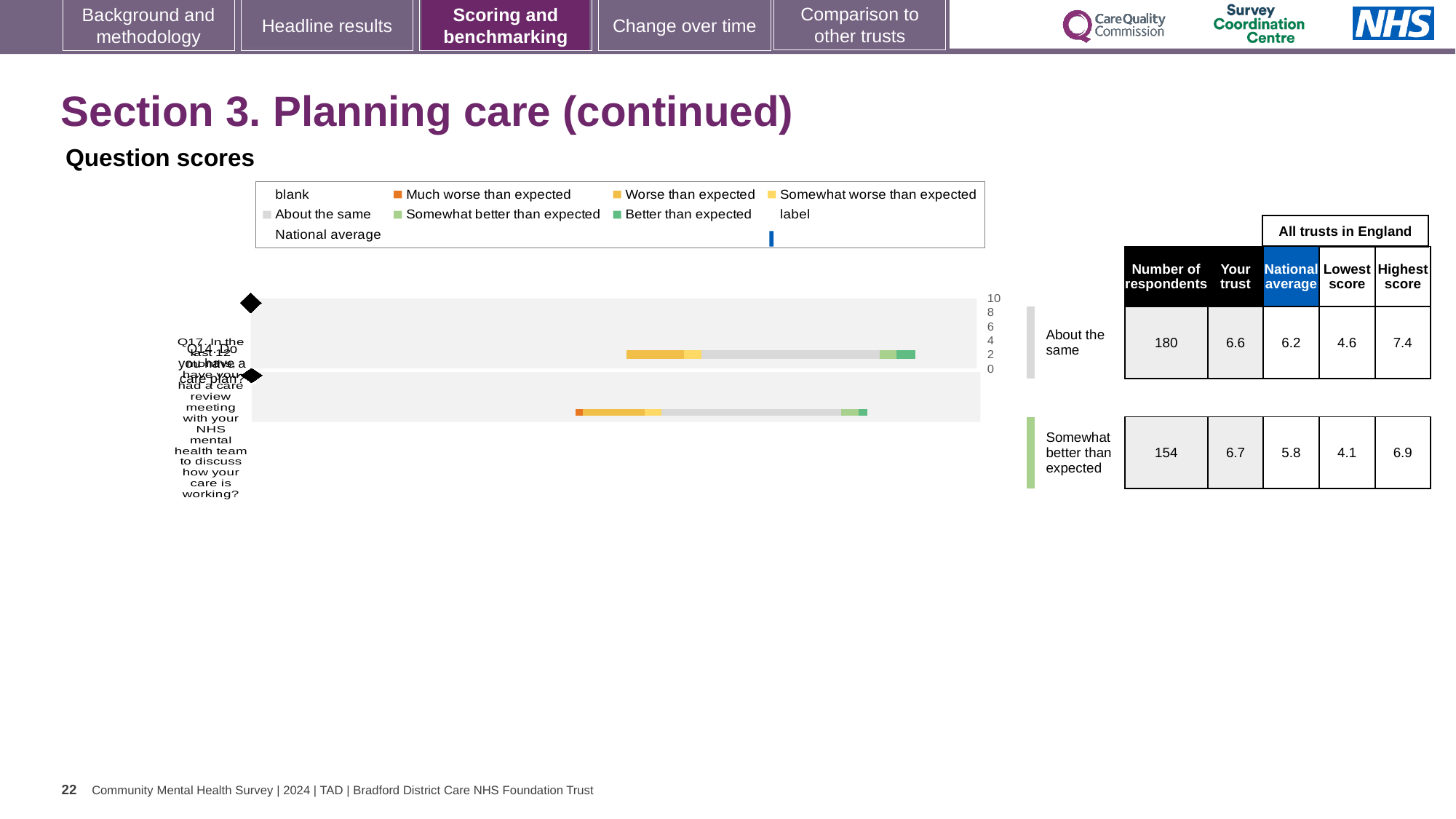
For the row rated 'About the same', what is the difference between the highest and lowest scores among all trusts in England? 2.8 In the table, what is the highest score among all trusts in England for the row rated 'About the same'? 7.4 What kind of chart is shown under 'Question scores'? bar chart For the row rated 'Somewhat better than expected', how much higher is the 'Your trust' score than the national average? 0.9 How many more respondents does the 'About the same' row have than the 'Somewhat better than expected' row? 26 In the table, what is the number of respondents for the row rated 'About the same'? 180 In the table, what is the lowest score among all trusts in England for the row rated 'Somewhat better than expected'? 4.1 In the chart legend, what colour represents 'Much worse than expected'? orange In the table, what is the national average for the row rated 'About the same'? 6.2 How many bars are plotted in the Question scores chart? 2 Which row has more respondents: 'About the same' or 'Somewhat better than expected'? About the same In the table, what is the 'Your trust' score for the row rated 'Somewhat better than expected'? 6.7